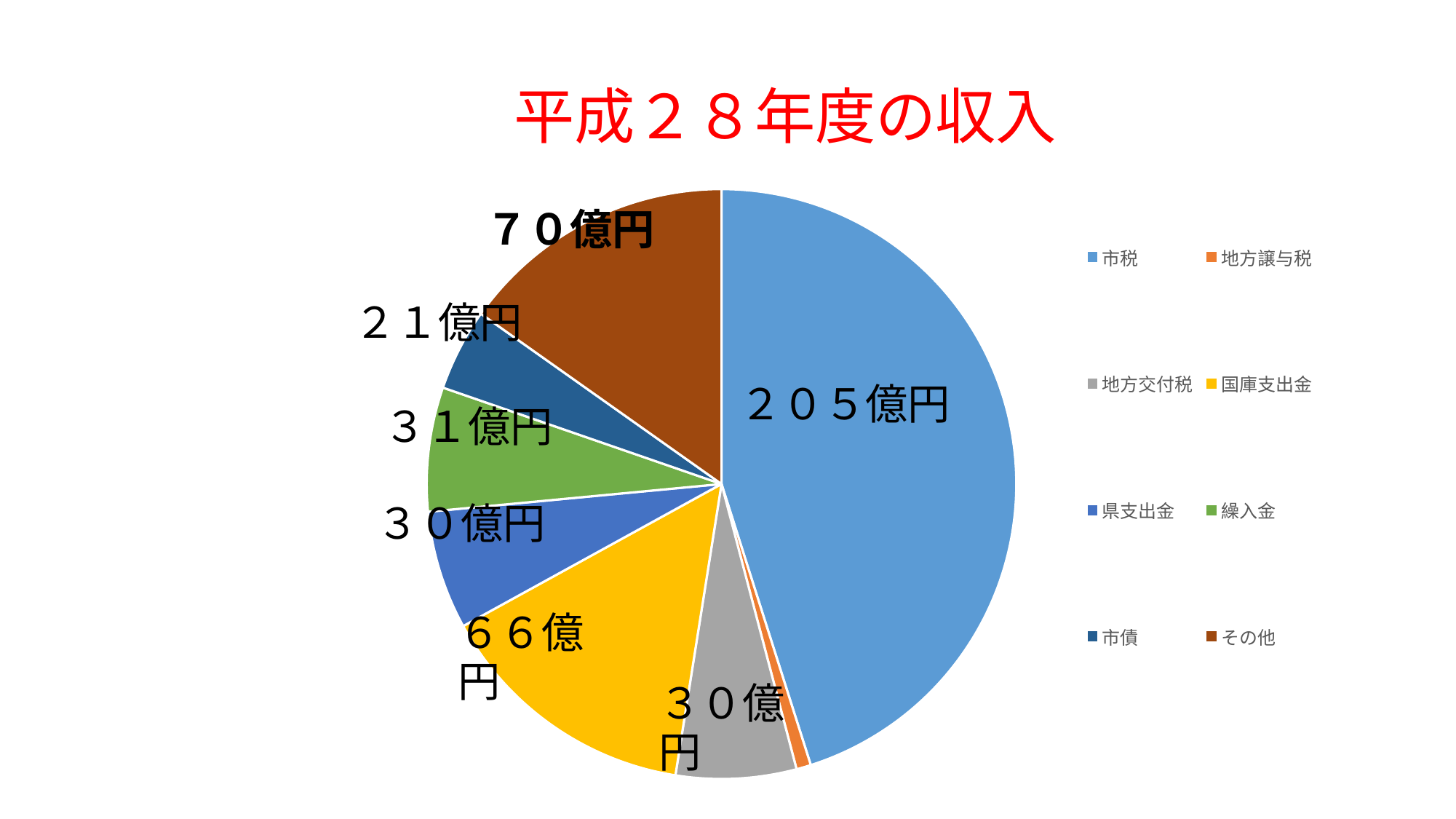
What is the value for 市債 in the pie chart? ２１億円 What is the difference between the values for 市税 and その他? １３５億円 What is the value for 国庫支出金 in the pie chart? ６６億円 What is the title of the chart on the slide? 平成２８年度の収入 Which category has the largest slice of the pie chart? 市税 What is the value for 市税 in the pie chart? ２０５億円 Which category has the smallest slice of the pie chart? 地方譲与税 Which is larger, the value for 繰入金 or the value for 市債? 繰入金 What kind of chart is shown on the slide? Pie chart What is the value for その他 in the pie chart? ７０億円 What is the value for 繰入金 in the pie chart? ３１億円 How many categories does the legend of the pie chart list? 8